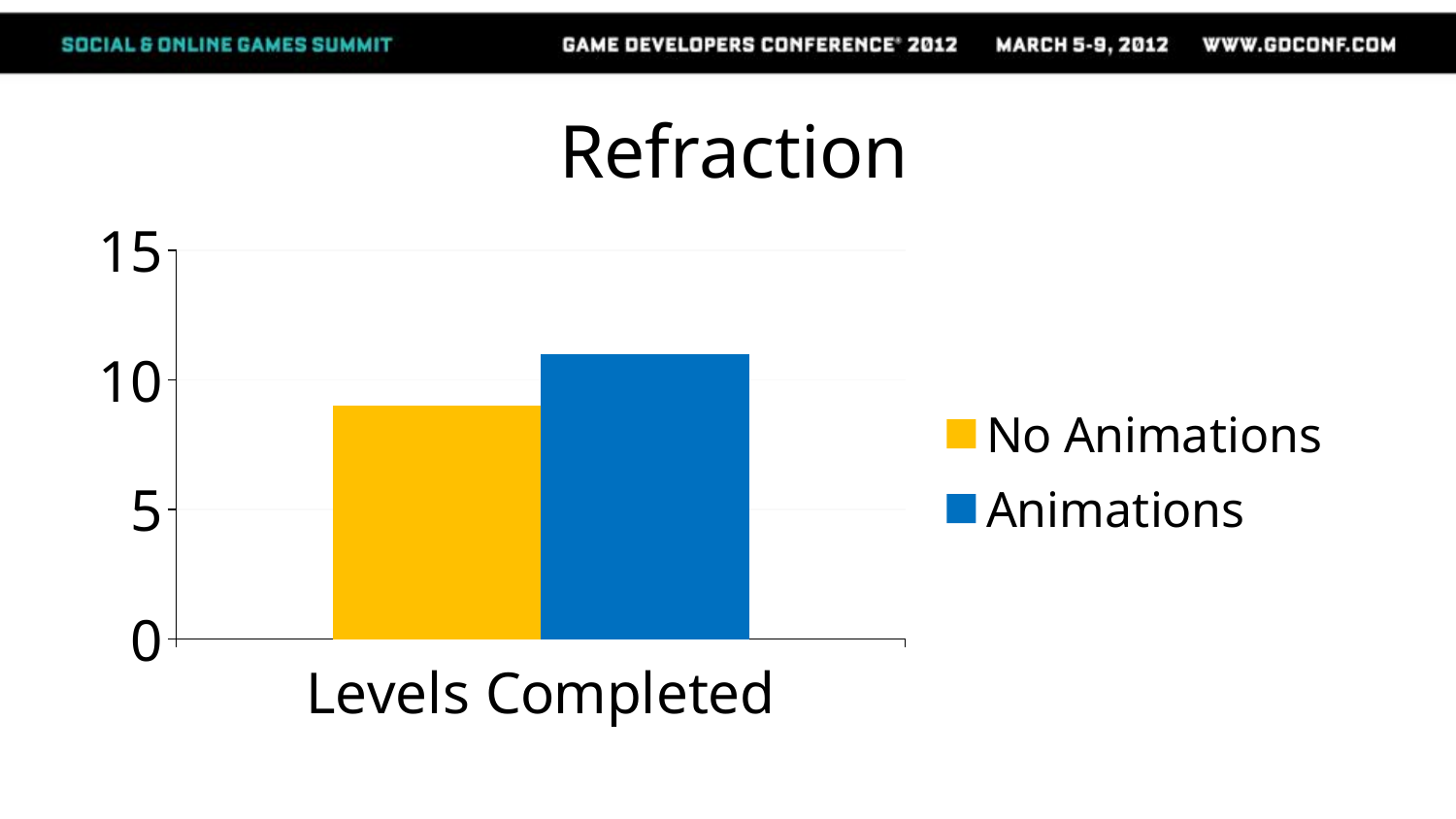
Which series has the lowest value for Levels Completed? No Animations Is the value for Animations greater or less than 15? less How many categories are shown on the x axis? 1 Which series has the highest value for Levels Completed? Animations Is the value for No Animations greater or less than 10? less Is the value for Animations greater or less than 10? greater Which series has the taller bar for Levels Completed, No Animations or Animations? Animations What is the title of the chart? Refraction How many series does the legend list? 2 What kind of chart is shown on the slide? bar chart What is the category label on the x axis? Levels Completed